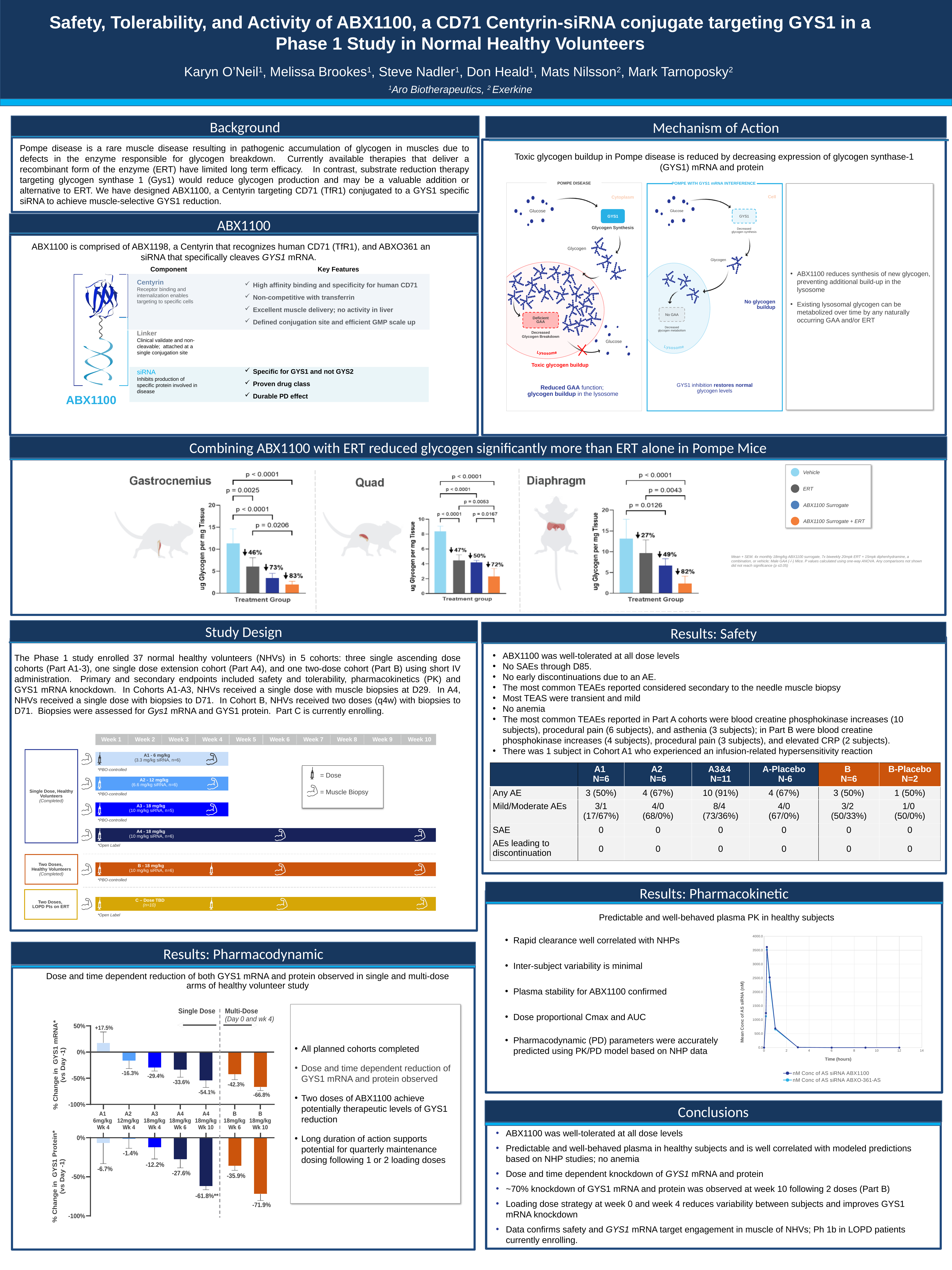
In the GYS1 protein chart of the Pharmacodynamic section, what is the difference in percentage points between the B Wk 10 value (-71.9%) and the B Wk 6 value (-35.9%)? 36 percentage points In the GYS1 mRNA chart of the Pharmacodynamic section, which bar shows the largest reduction? B 18mg/kg Wk 10 What kind of chart is shown in the Results: Pharmacokinetic section? Line chart How many bars are plotted in the GYS1 mRNA chart of the Pharmacodynamic section? 7 In the Results: Pharmacodynamic section, what is the % change in GYS1 mRNA for the B 18mg/kg Wk 10 bar? -66.8% In the GYS1 mRNA chart of the Pharmacodynamic section, which bar is the only one with a positive value? A1 6mg/kg Wk 4 In the Results: Pharmacodynamic section, what is the % change in GYS1 protein for the A4 18mg/kg Wk 10 bar? -61.8% In the Diaphragm chart of the Pompe mice section, which shows a larger labeled reduction: the ERT bar or the ABX1100 Surrogate bar? ABX1100 Surrogate (49%) In the Gastrocnemius chart of the Pompe mice section, what percentage reduction is labeled above the ABX1100 Surrogate + ERT bar? 83% How many treatment groups does the legend of the Pompe mice charts list? 4